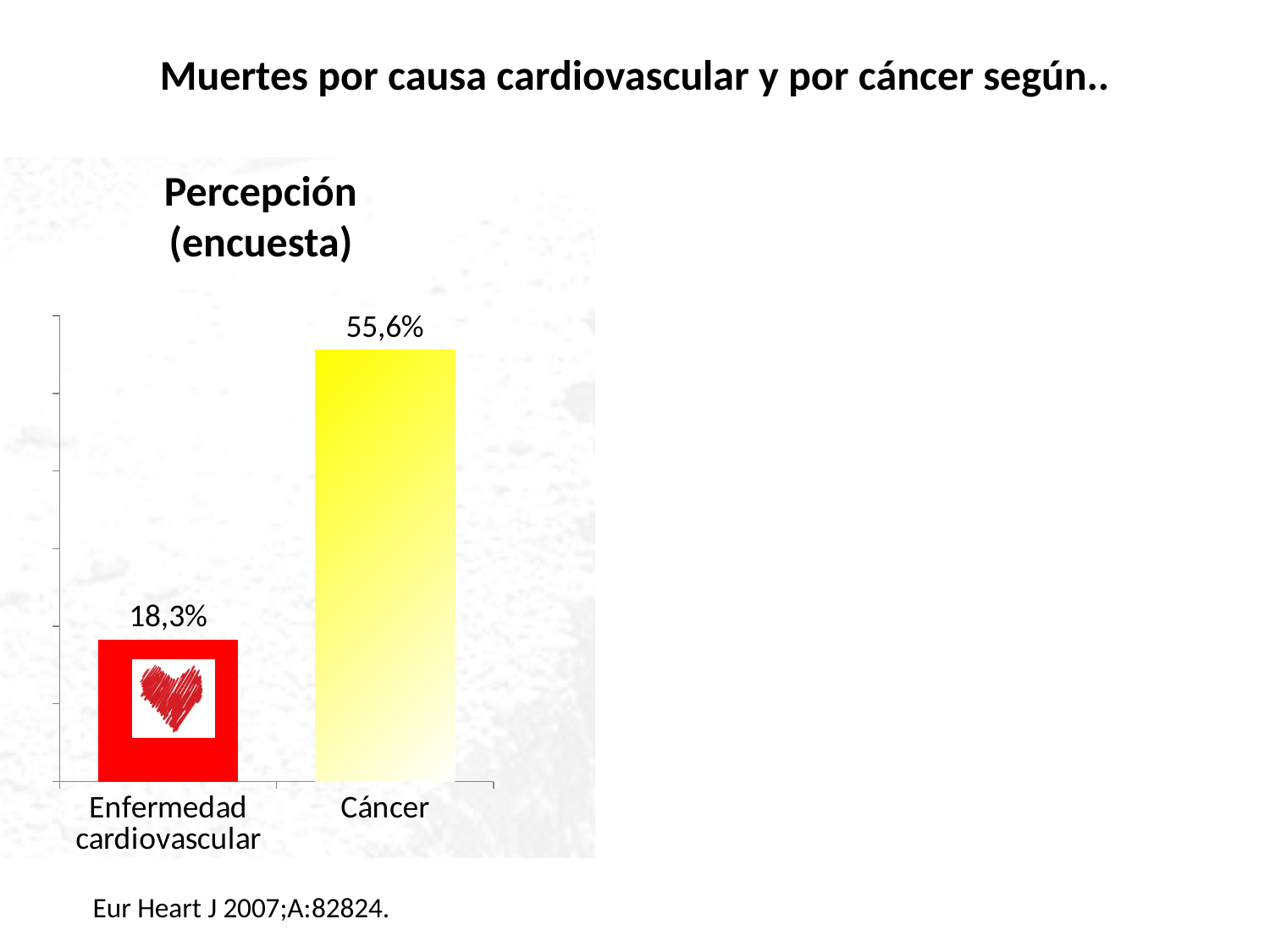
What is the value for Cáncer? 55,6% What is the value for Enfermedad cardiovascular? 18,3% Which is larger, the value for Cáncer or the value for Enfermedad cardiovascular? Cáncer Which category has the lowest value? Enfermedad cardiovascular Which category has the highest value? Cáncer How many categories are shown in the chart? 2 What kind of chart is shown on the slide? Bar chart What is the title of the chart? Percepción (encuesta) What is the difference between the values for Cáncer and Enfermedad cardiovascular? 37,3% What colour is the bar for Cáncer? Yellow